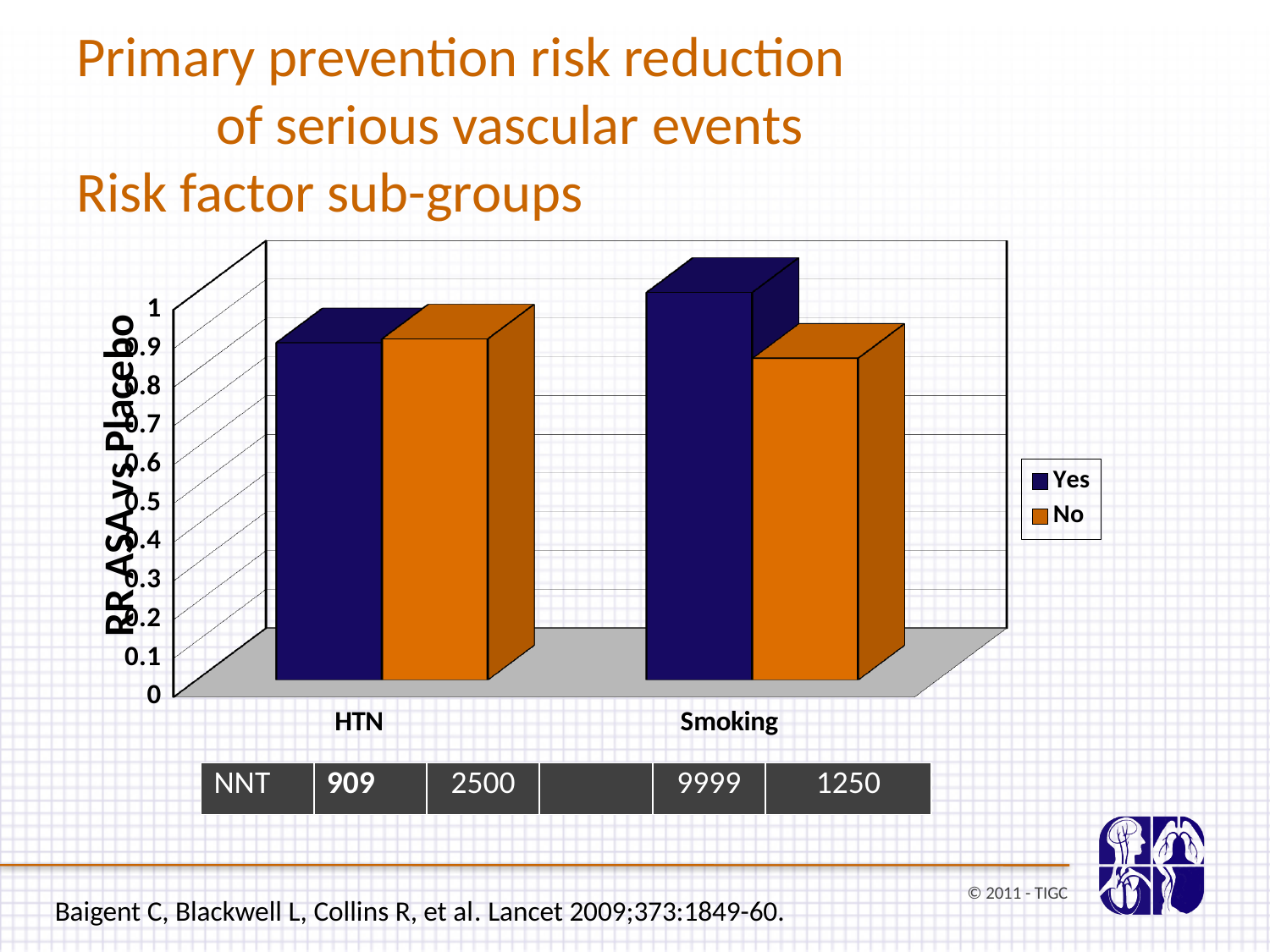
What is the highest value shown on the vertical axis of the chart? 1 Which category and series has the tallest bar in the chart? Smoking, Yes How many series does the chart's legend list? 2 Is the value for HTN Yes greater or less than 0.5? greater For the Smoking category, which bar is taller, Yes or No? Yes What are the two series named in the chart's legend? Yes and No How many risk factor categories are shown on the x axis of the chart? 2 Is the value for Smoking No greater or less than 0.5? greater What is the label on the vertical axis of the chart? RR ASA vs Placebo Is the value for HTN No greater or less than 0.7? greater What kind of chart is shown on the slide? bar chart